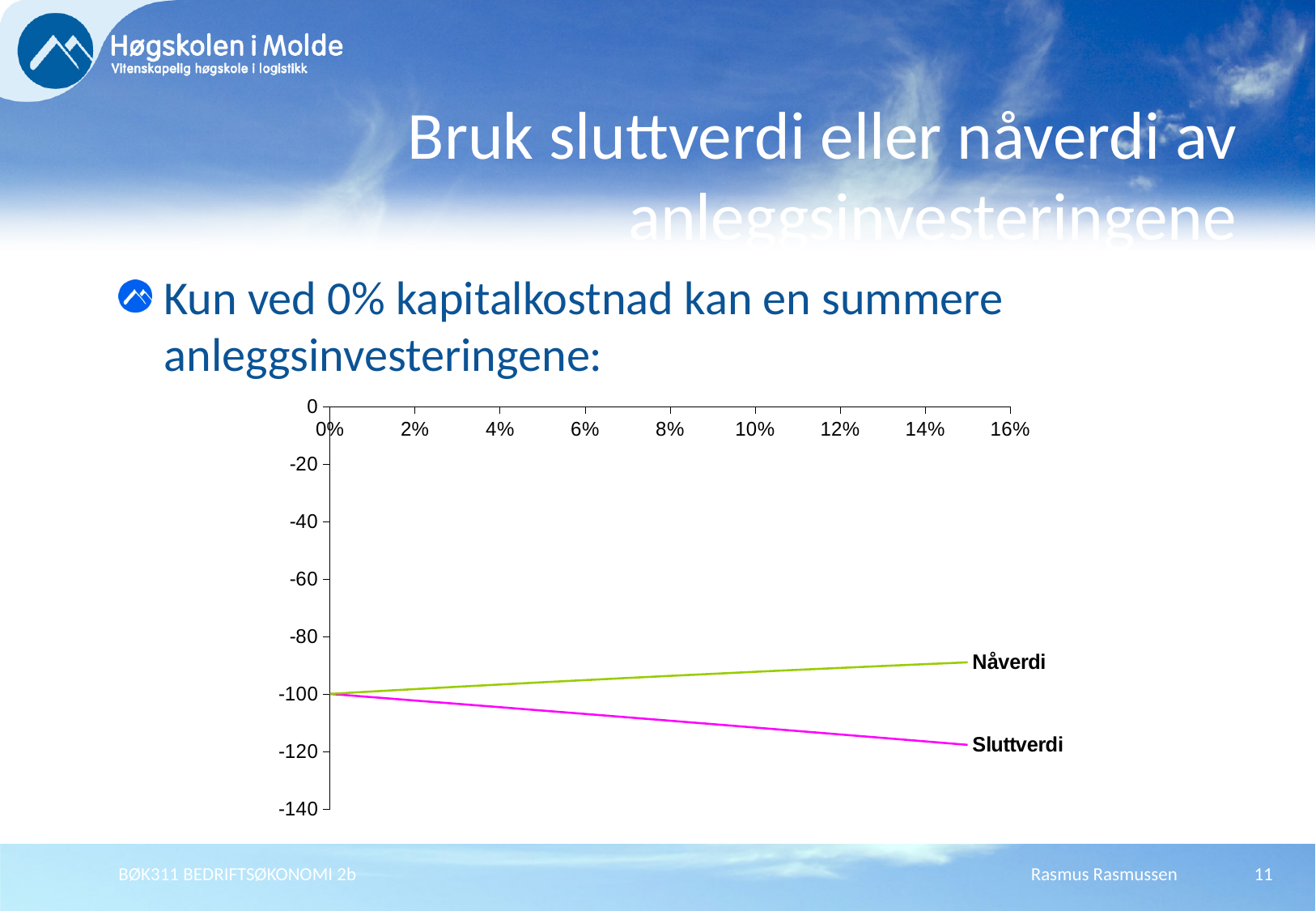
What kind of chart is shown on the slide? line chart How many tick labels are shown on the x axis? 9 Is the value for Nåverdi at 14% greater or less than -80? less At 14%, which series has the higher value, Nåverdi or Sluttverdi? Nåverdi What is the value of Sluttverdi at 0%? -100 Does the Sluttverdi line rise or fall as the rate increases along the x axis? fall At which x-axis value do the Nåverdi and Sluttverdi lines meet? 0% Does the Nåverdi line rise or fall as the rate increases along the x axis? rise Is the value for Nåverdi at 14% greater or less than -100? greater How many data series are plotted in the chart? 2 Is the value for Sluttverdi at 14% greater or less than -100? less What is the value of Nåverdi at 0%? -100